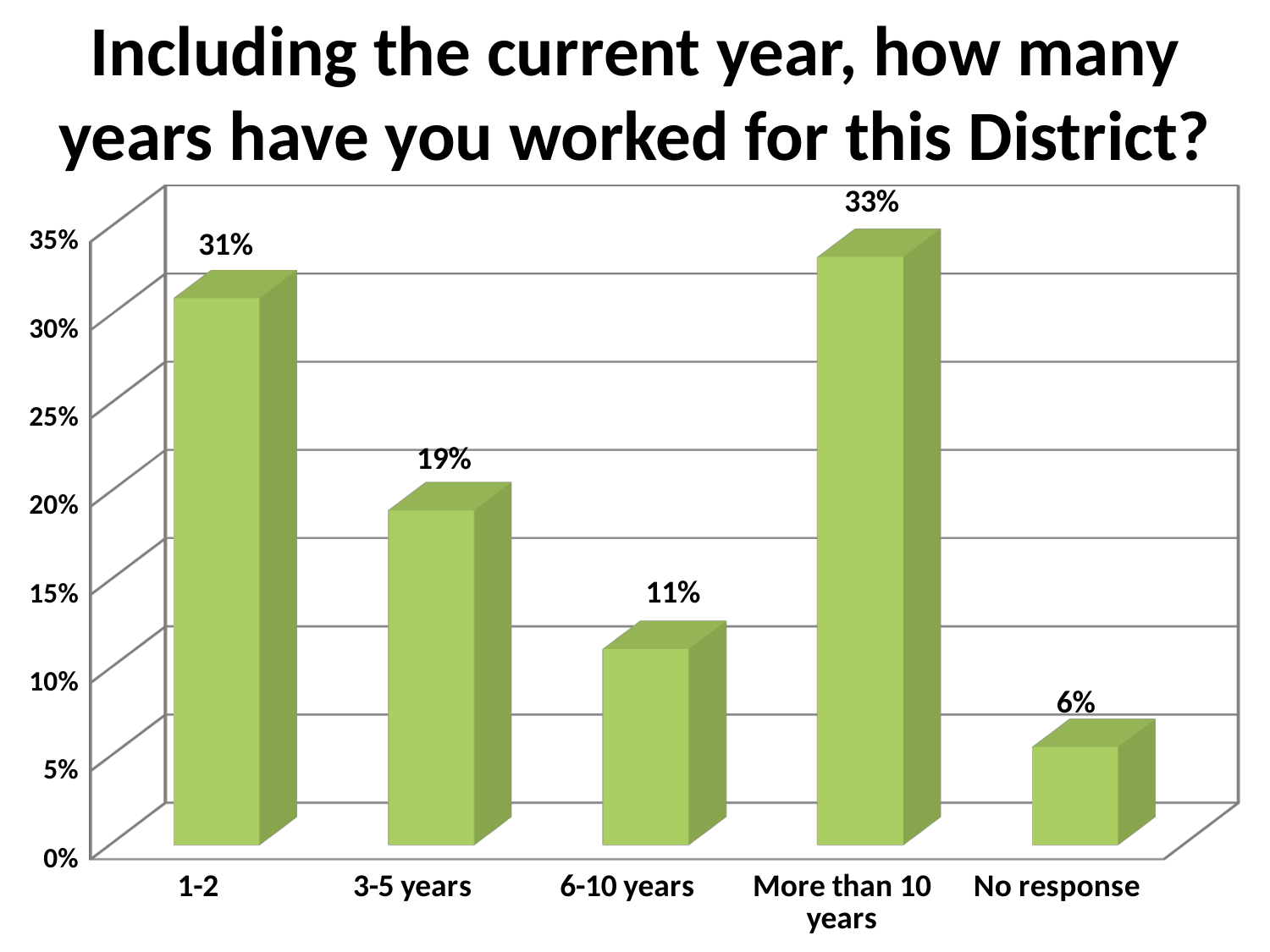
What percentage of respondents gave no response? 6% How many categories are shown on the x axis? 5 What is the difference in percentage points between the 3-5 years and 6-10 years categories? 8 Which category has the lowest percentage? No response What is the title of the chart? Including the current year, how many years have you worked for this District? Which category has the highest percentage? More than 10 years What percentage is shown for 6-10 years? 11% What kind of chart is shown on the slide? Bar chart What percentage of respondents have worked for the District for 1-2 years? 31% What is the difference in percentage points between the More than 10 years and 1-2 categories? 2 What is the value shown for the 3-5 years category? 19% Which is larger, the value for 1-2 years or the value for 3-5 years? 1-2